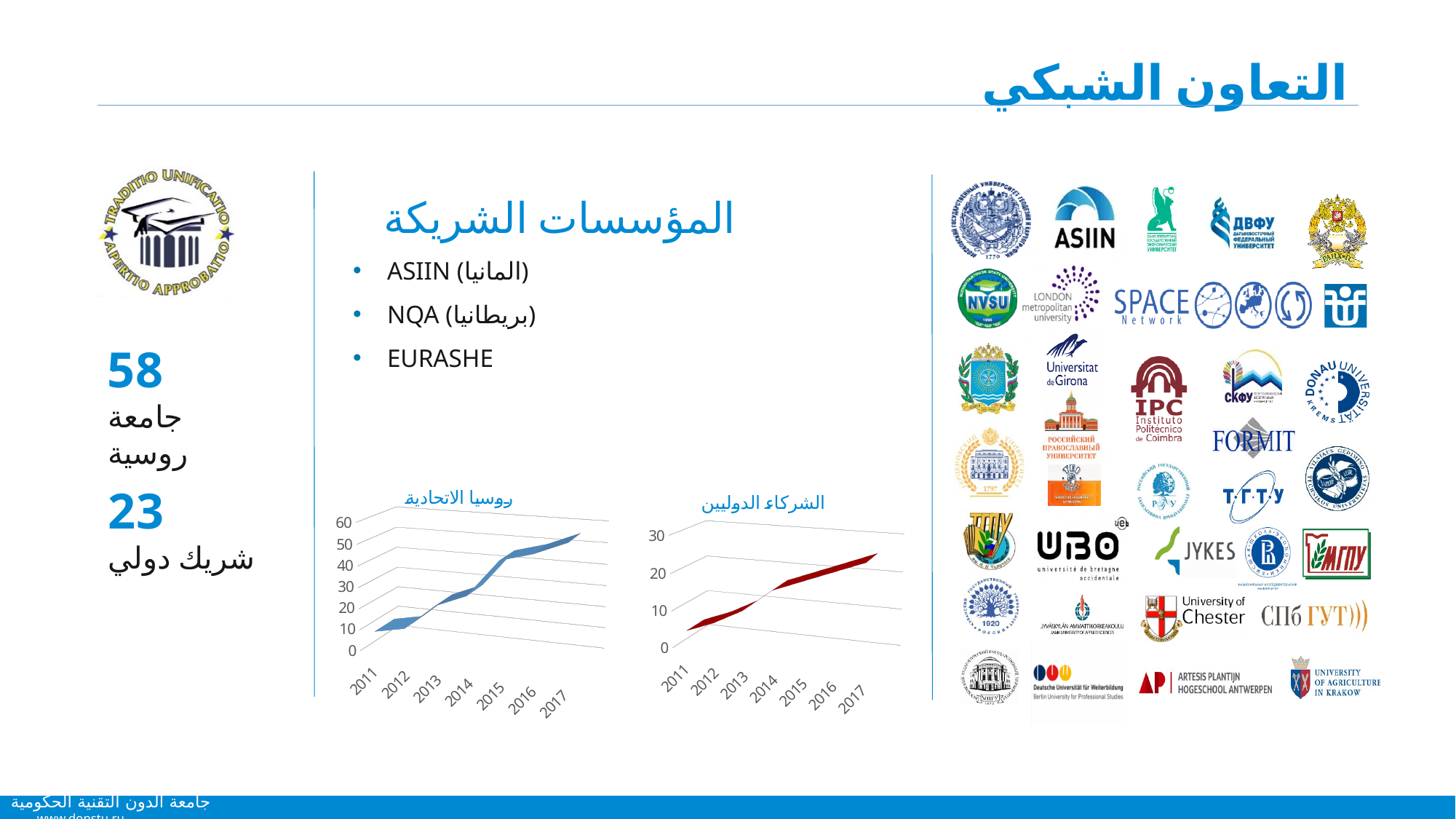
In the chart titled "روسيا الاتحادية", is the value for 2017 greater or less than 40? greater In the chart titled "روسيا الاتحادية", do the values rise or fall from 2011 to 2017? rise What is the highest tick shown on the vertical axis of the chart titled "الشركاء الدوليين"? 30 What kind of chart is the chart titled "الشركاء الدوليين"? line chart In the chart titled "الشركاء الدوليين", how many years are shown on the x axis? 7 In the chart titled "روسيا الاتحادية", how many years are shown on the x axis? 7 In the chart titled "روسيا الاتحادية", which year has the highest value? 2017 What kind of chart is the chart titled "روسيا الاتحادية"? line chart In the chart titled "الشركاء الدوليين", which year has the highest value? 2017 In the chart titled "روسيا الاتحادية", which year has the lowest value? 2011 In the chart titled "الشركاء الدوليين", is the value for 2011 greater or less than 10? less In the chart titled "الشركاء الدوليين", do the values rise or fall from 2011 to 2017? rise